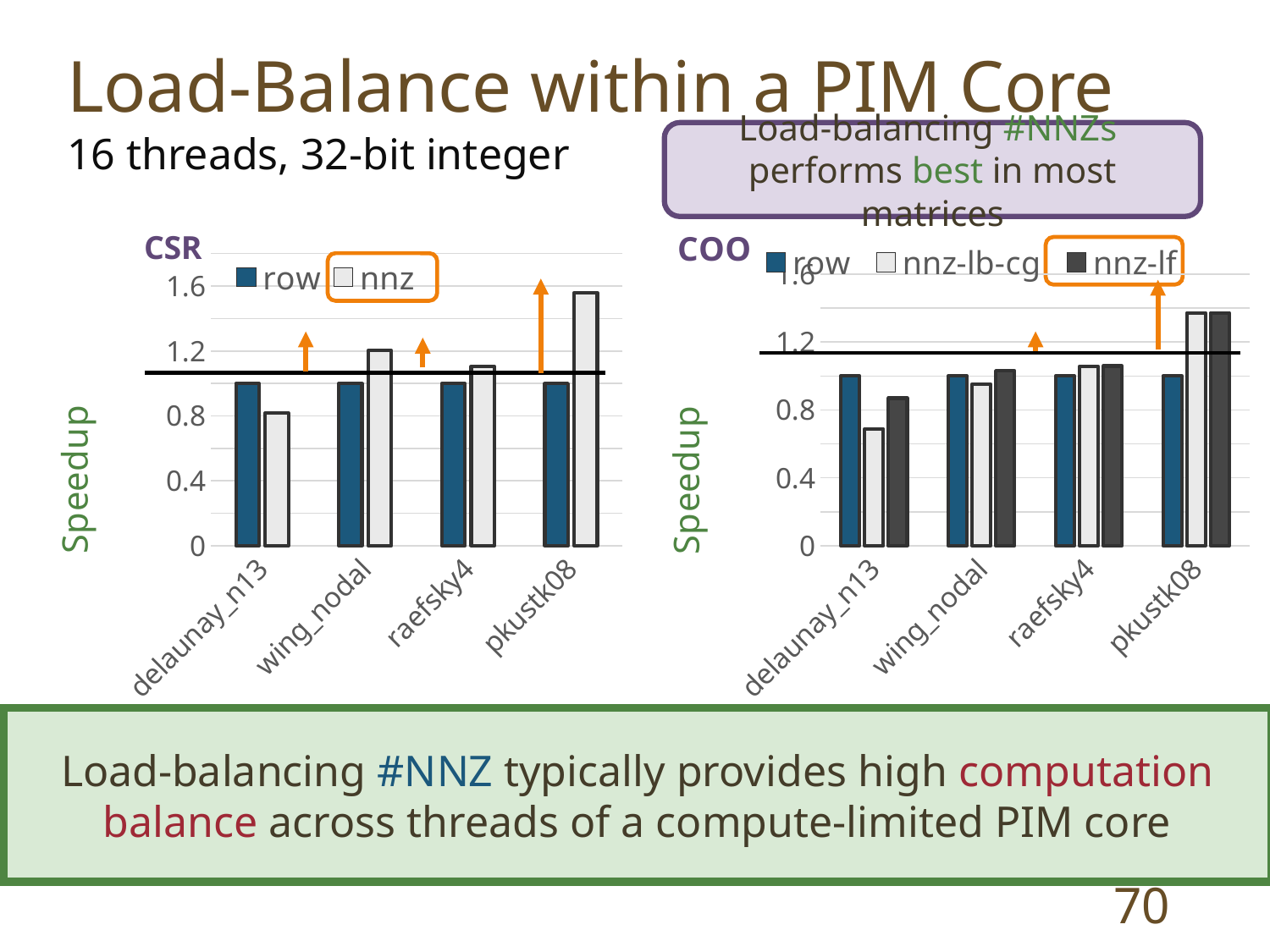
In the COO chart, is the nnz-lf value for pkustk08 greater or less than 1.2? greater In the CSR chart, which matrix has the highest nnz speedup? pkustk08 In the CSR chart, is the nnz value for delaunay_n13 greater or less than 1.2? less How many matrices (categories) are shown on the x axis of the COO chart? 4 In the CSR chart, is the nnz value for pkustk08 greater or less than 1.2? greater In the COO chart, for delaunay_n13, which is larger: nnz-lb-cg or nnz-lf? nnz-lf What is the label on the y axis of the CSR chart? Speedup How many series does the legend of the COO chart on the right list? 3 What kind of chart is the CSR chart on the left? bar chart In the CSR chart, which matrix has the lowest nnz speedup? delaunay_n13 How many series does the legend of the CSR chart on the left list? 2